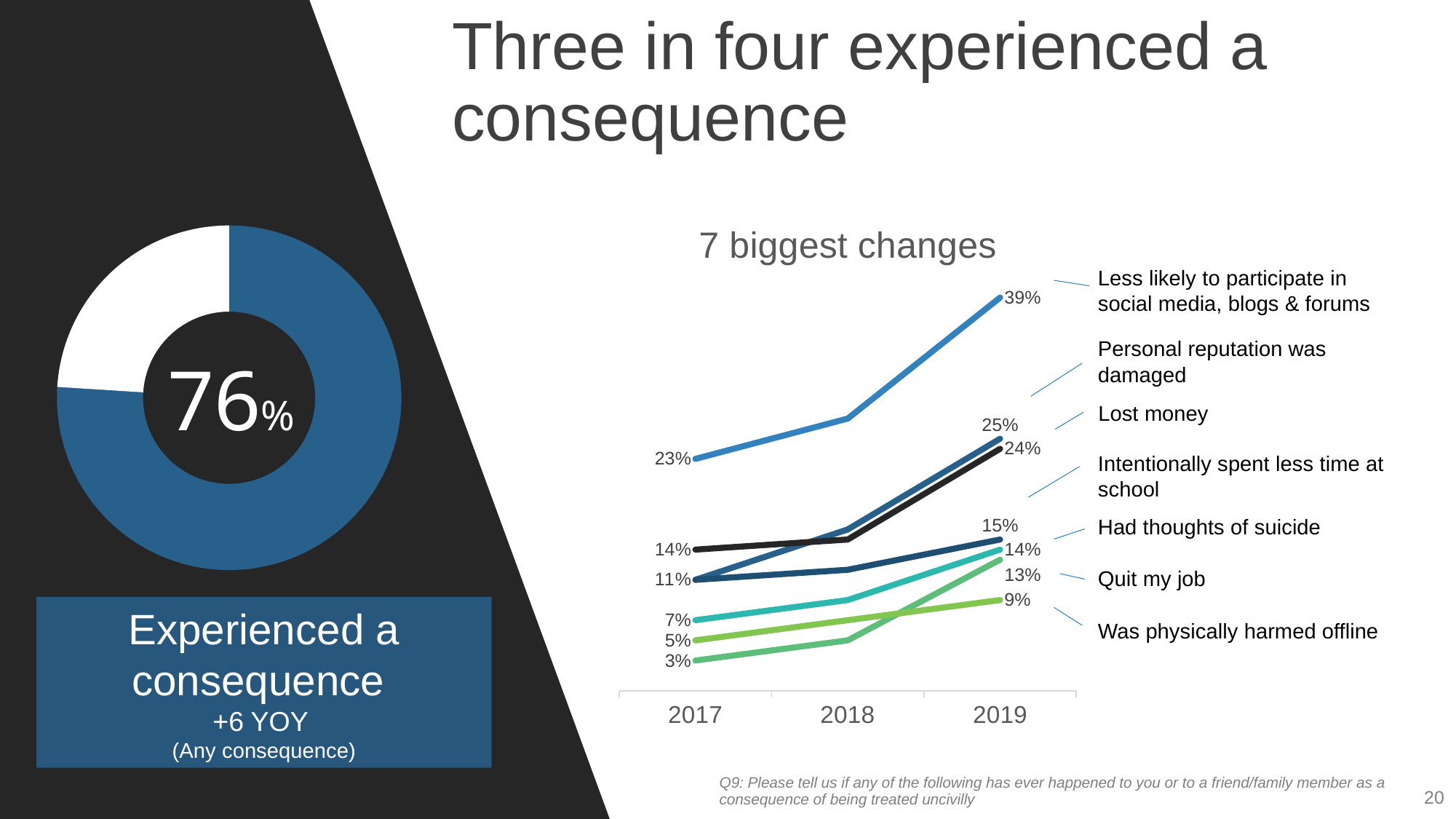
On the '7 biggest changes' chart, what is the highest value shown for 2019? 39% On the donut chart on the left, what percentage experienced a consequence? 76% On the '7 biggest changes' chart, what is the lowest value shown for 2019? 9% On the '7 biggest changes' chart, how many years are shown on the x axis? 3 On the '7 biggest changes' chart, which consequence has the highest value in 2019? Less likely to participate in social media, blogs & forums On the '7 biggest changes' chart, how many series (consequences) are plotted? 7 What kind of chart is the '7 biggest changes' chart? line chart On the '7 biggest changes' chart, does the line for 'Less likely to participate in social media, blogs & forums' rise or fall from 2017 to 2019? rise What kind of chart is the chart on the left showing 76%? donut chart On the '7 biggest changes' chart, what was the value for 'Less likely to participate in social media, blogs & forums' in 2017? 23% On the '7 biggest changes' chart, by how many percentage points did 'Less likely to participate in social media, blogs & forums' increase from 2017 to 2019? 16 What is the year-over-year change shown for 'Experienced a consequence' on the left of the slide? +6 YOY